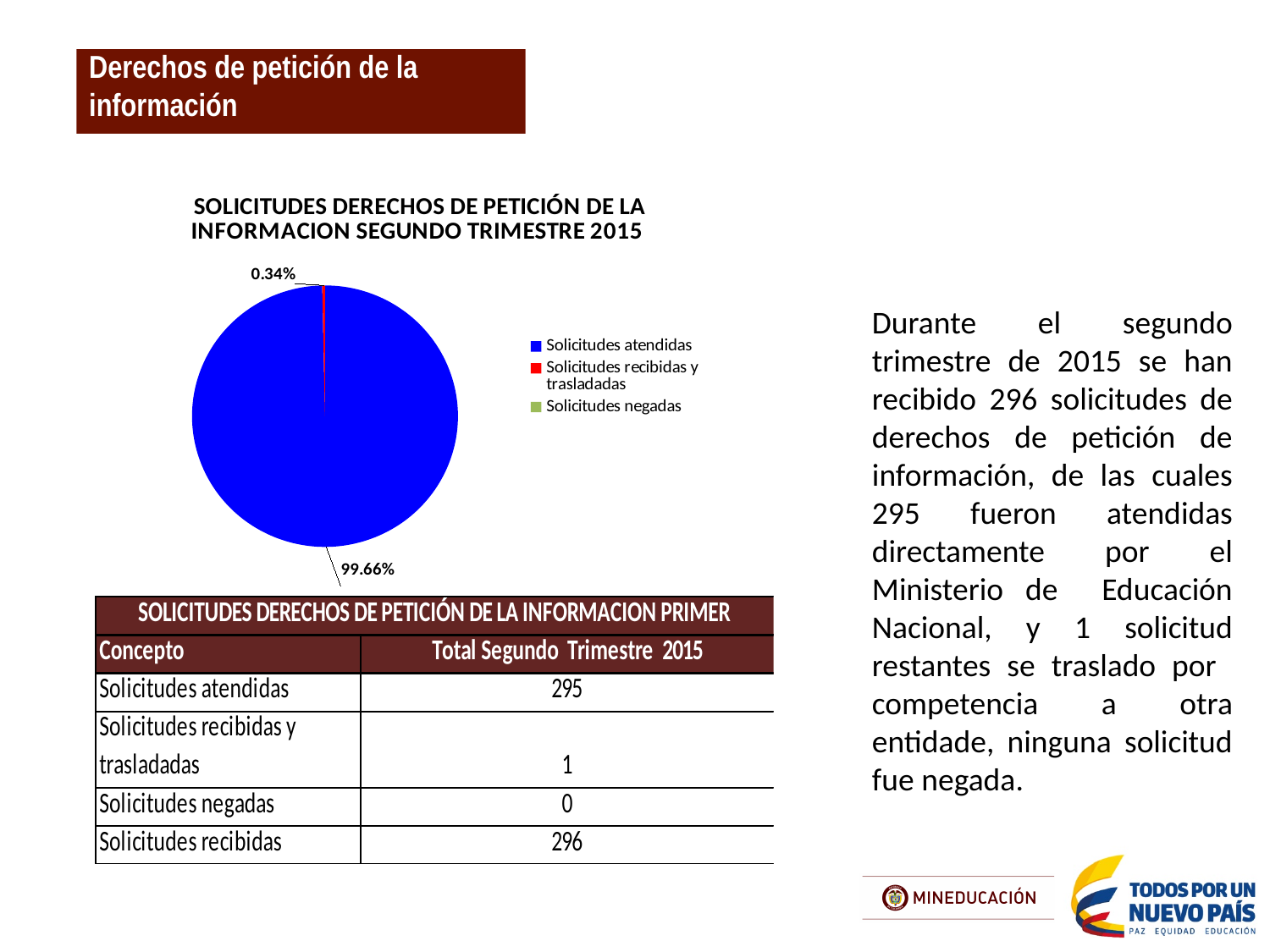
What kind of chart is shown on the slide? pie chart What colour is the slice for 'Solicitudes atendidas' in the pie chart? blue According to the table below the chart, how many 'Solicitudes atendidas' were there in the second quarter of 2015? 295 What share of the pie does 'Solicitudes atendidas' represent? 99.66% Which category has the largest slice of the pie chart? Solicitudes atendidas What is the difference in percentage points between the 99.66% slice and the 0.34% slice? 99.32 How many entries does the pie chart's legend list? 3 According to the table below the chart, how many 'Solicitudes negadas' were there? 0 What is the title of the pie chart? SOLICITUDES DERECHOS DE PETICIÓN DE LA INFORMACION SEGUNDO TRIMESTRE 2015 According to the table below the chart, what is the total of 'Solicitudes recibidas'? 296 Which of the two labelled slices is larger, 'Solicitudes atendidas' or 'Solicitudes recibidas y trasladadas'? Solicitudes atendidas What share of the pie does 'Solicitudes recibidas y trasladadas' represent? 0.34%